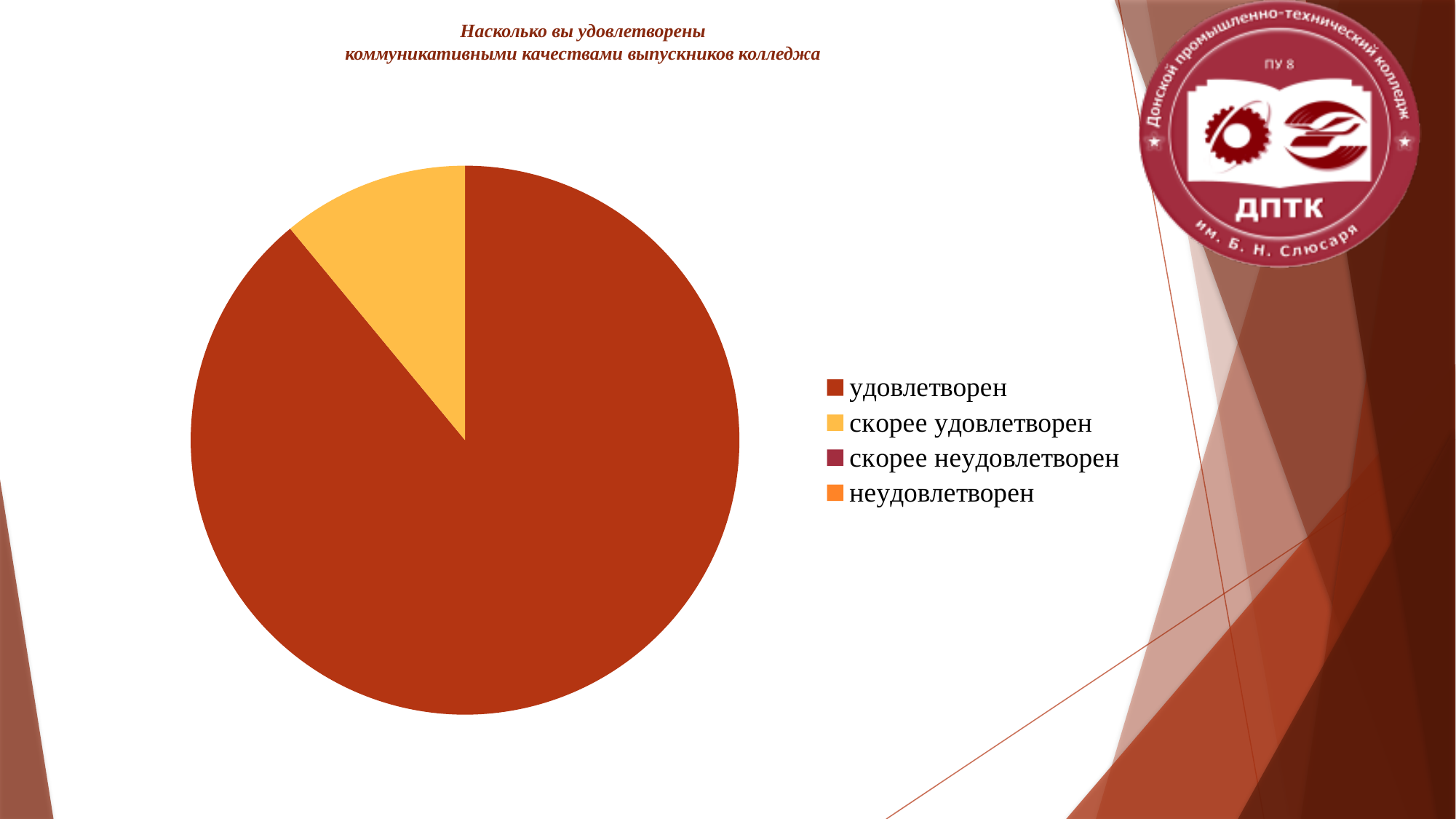
Which category has the largest slice in the pie chart? удовлетворен How many slices are visible in the pie chart? 2 What colour is the slice for скорее удовлетворен in the pie chart? yellow What kind of chart is shown on the slide? pie chart How many entries does the legend of the pie chart list? 4 Which slice is larger: удовлетворен or скорее удовлетворен? удовлетворен What is the title of the chart on the slide? Насколько вы удовлетворены коммуникативными качествами выпускников колледжа